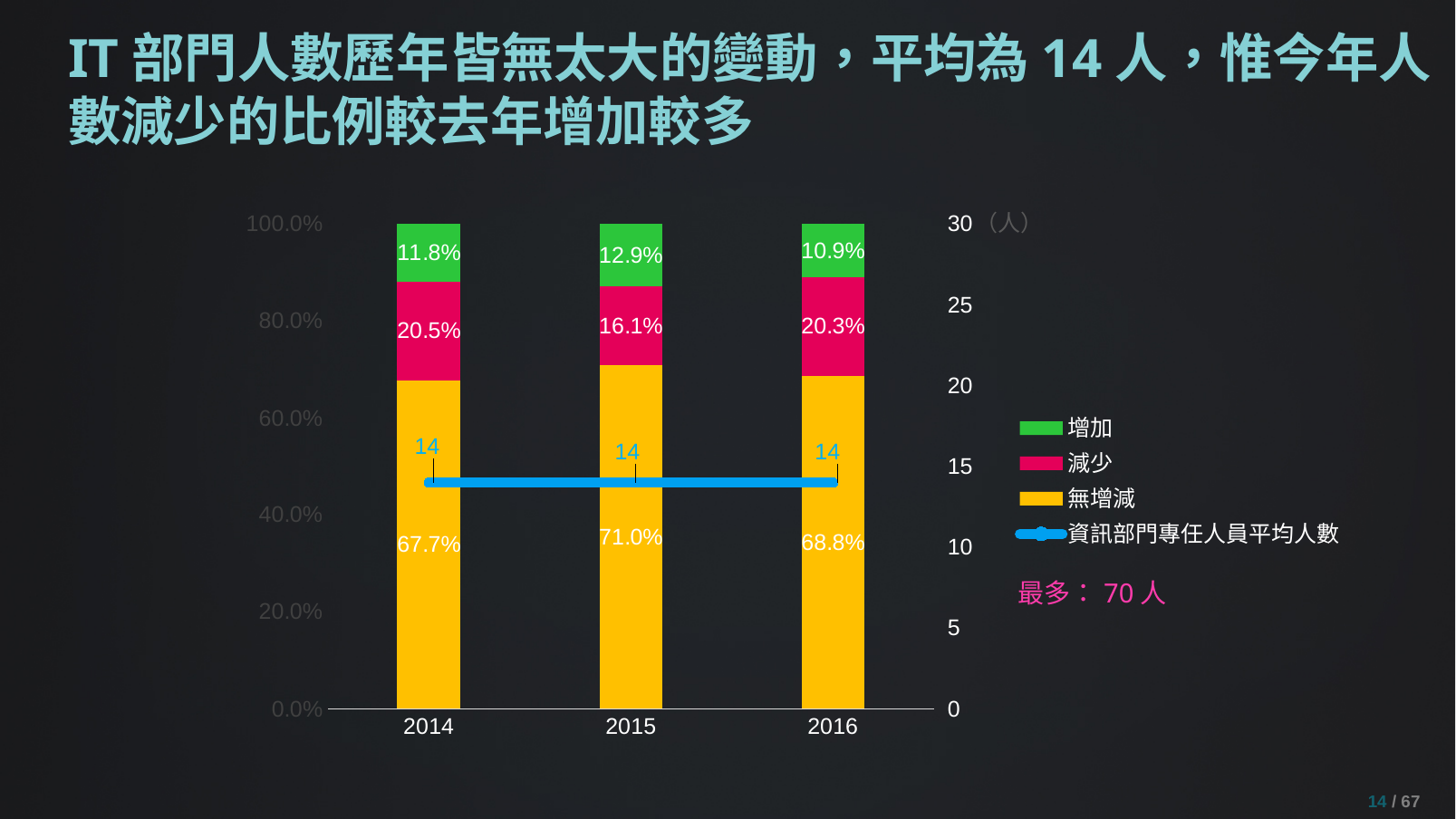
What kind of chart is this? Stacked bar chart with a line What is the value for 無增減 in 2015? 71.0% In which year is the 增加 share the highest? 2015 What is the maximum number of people noted next to the legend (最多)? 70 人 In which year is the 減少 share the lowest? 2015 How many series does the legend list? 4 What is the 資訊部門專任人員平均人數 value for 2015? 14 How many years are shown on the x axis? 3 What is the value for 增加 in 2014? 11.8% What is the difference between the 減少 share in 2016 and in 2015? 4.2% Which is larger, the 無增減 share in 2014 or in 2016? 2016 What is the value for 減少 in 2016? 20.3%